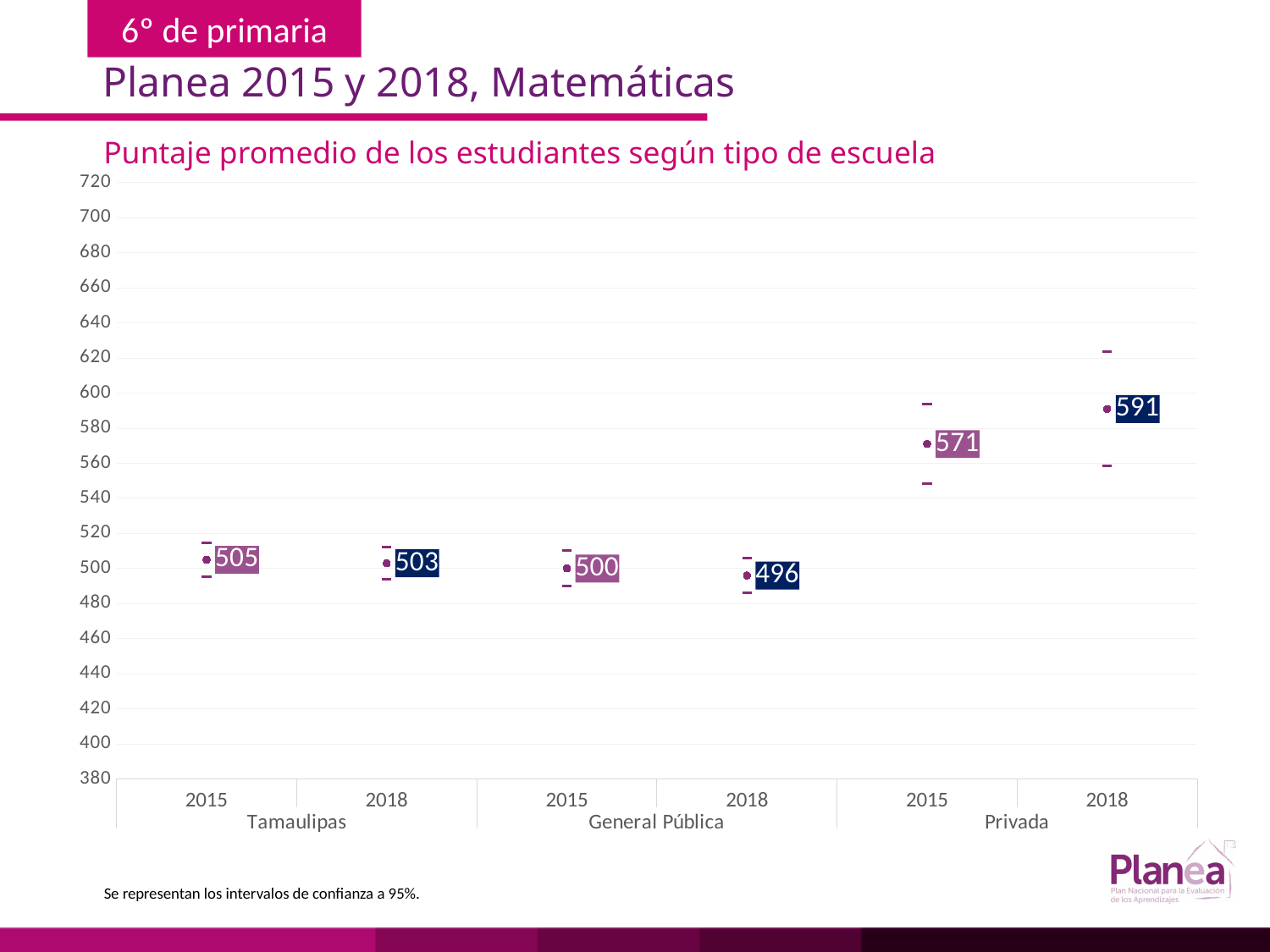
What is the average score for Tamaulipas in 2018? 503 Did the Privada average score rise or fall from 2015 to 2018? rise Which school type and year has the lowest average score? General Pública 2018 What is the difference between the Tamaulipas score and the General Pública score in 2015? 5 Which school type and year has the highest average score? Privada 2018 What is the average score for General Pública in 2018? 496 Which is larger, the Tamaulipas score in 2018 or the General Pública score in 2018? Tamaulipas 2018 How many data points are plotted on the chart? 6 What is the average score for Tamaulipas in 2015? 505 What is the difference between the Privada scores in 2018 and 2015? 20 What is the title of the chart? Puntaje promedio de los estudiantes según tipo de escuela What is the average score for Privada in 2015? 571